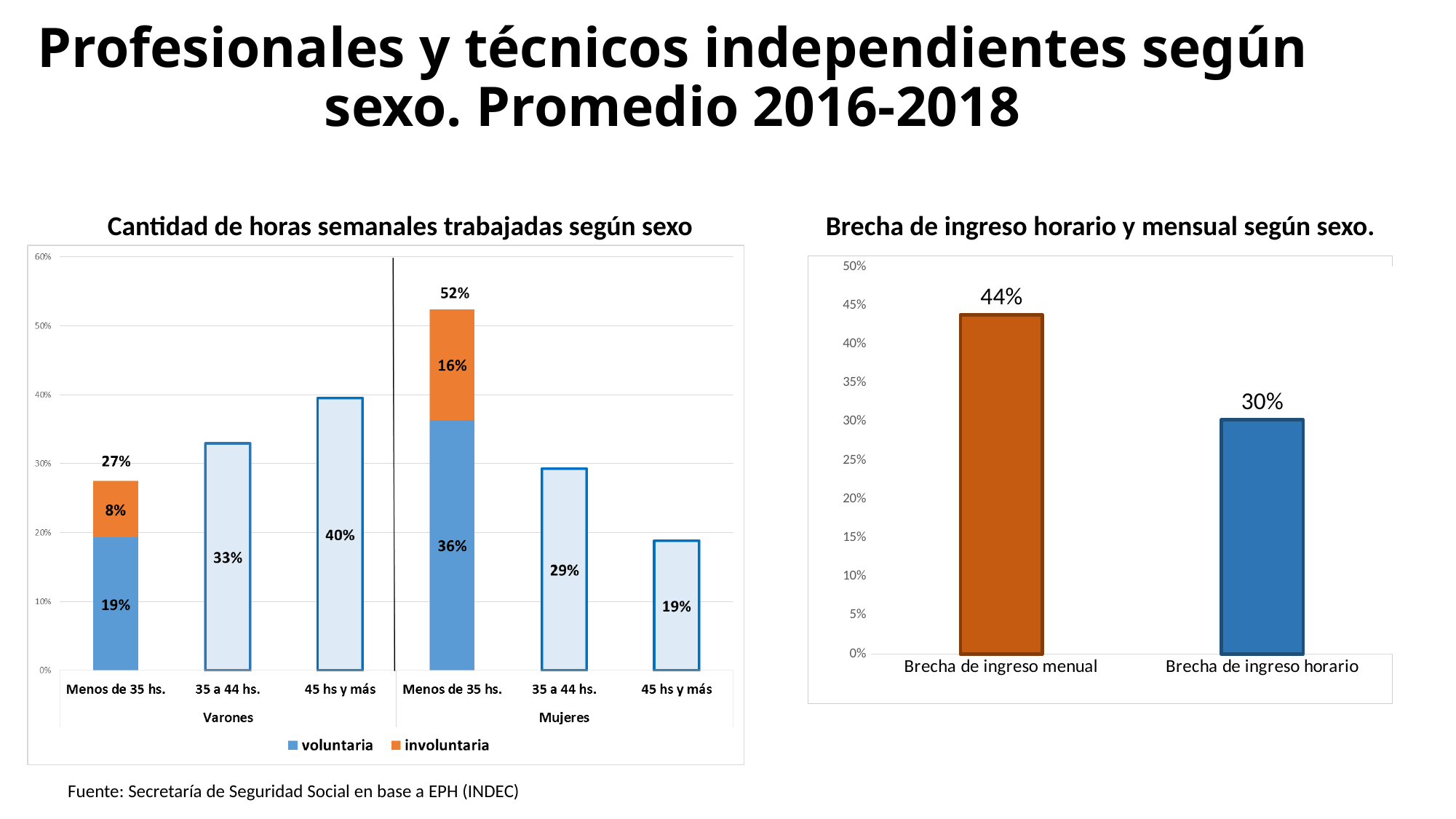
In the chart 'Cantidad de horas semanales trabajadas según sexo', what is the total of the stacked bar for Varones working 'Menos de 35 hs.'? 27% In the chart 'Brecha de ingreso horario y mensual según sexo.', what is the value for 'Brecha de ingreso horario'? 30% In the chart 'Cantidad de horas semanales trabajadas según sexo', which category has the highest value among Varones? 45 hs y más In the chart 'Cantidad de horas semanales trabajadas según sexo', which category has the lowest value among Mujeres? 45 hs y más In the chart 'Cantidad de horas semanales trabajadas según sexo', how many series does the legend list? 2 In the chart 'Cantidad de horas semanales trabajadas según sexo', what is the 'involuntaria' value for Mujeres working 'Menos de 35 hs.'? 16% In the chart 'Cantidad de horas semanales trabajadas según sexo', what is the total of the stacked bar for Mujeres working 'Menos de 35 hs.'? 52% In the chart 'Brecha de ingreso horario y mensual según sexo.', how many bars are plotted? 2 In the chart 'Cantidad de horas semanales trabajadas según sexo', which is larger: the '35 a 44 hs.' value for Varones or for Mujeres? Varones In the chart 'Brecha de ingreso horario y mensual según sexo.', what is the value for 'Brecha de ingreso menual'? 44% In the chart 'Cantidad de horas semanales trabajadas según sexo', what is the 'voluntaria' value for Varones working 'Menos de 35 hs.'? 19% In the chart 'Brecha de ingreso horario y mensual según sexo.', what is the difference between the monthly gap and the hourly gap? 14%